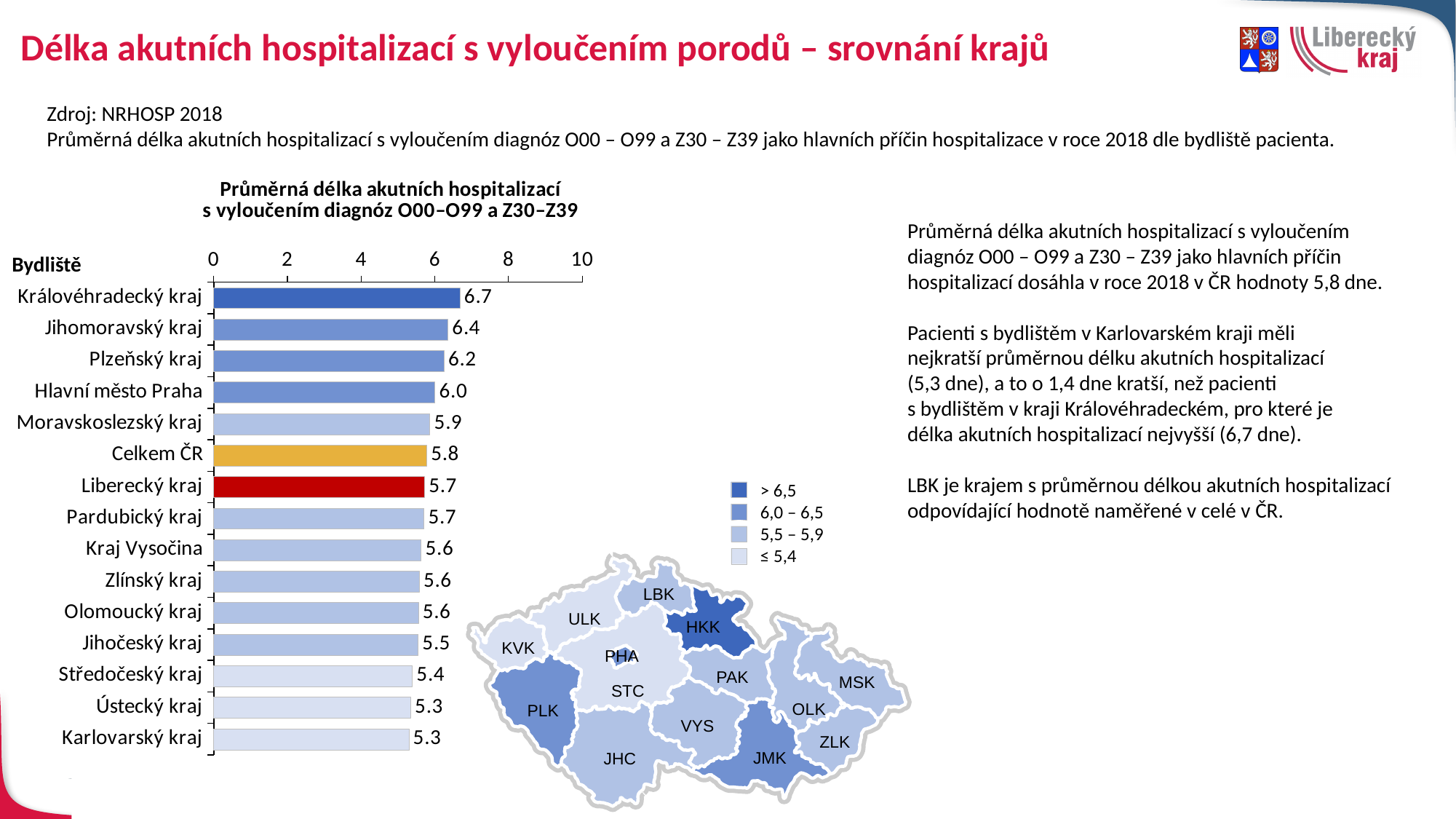
Which is larger, the value for Jihomoravský kraj or the value for Plzeňský kraj? Jihomoravský kraj What is the value for Hlavní město Praha? 6.0 What kind of chart is shown on the slide? bar chart Is the value for Moravskoslezský kraj greater or less than 6? less What is the value for Liberecký kraj? 5.7 What is the difference between the values for Královéhradecký kraj and Karlovarský kraj? 1.4 How many bars are shown in the chart? 15 What is the difference between the values for Celkem ČR and Liberecký kraj? 0.1 Which category has the highest value? Královéhradecký kraj What colour is the bar for Liberecký kraj? red What is the value for Královéhradecký kraj? 6.7 What is the value for Celkem ČR? 5.8